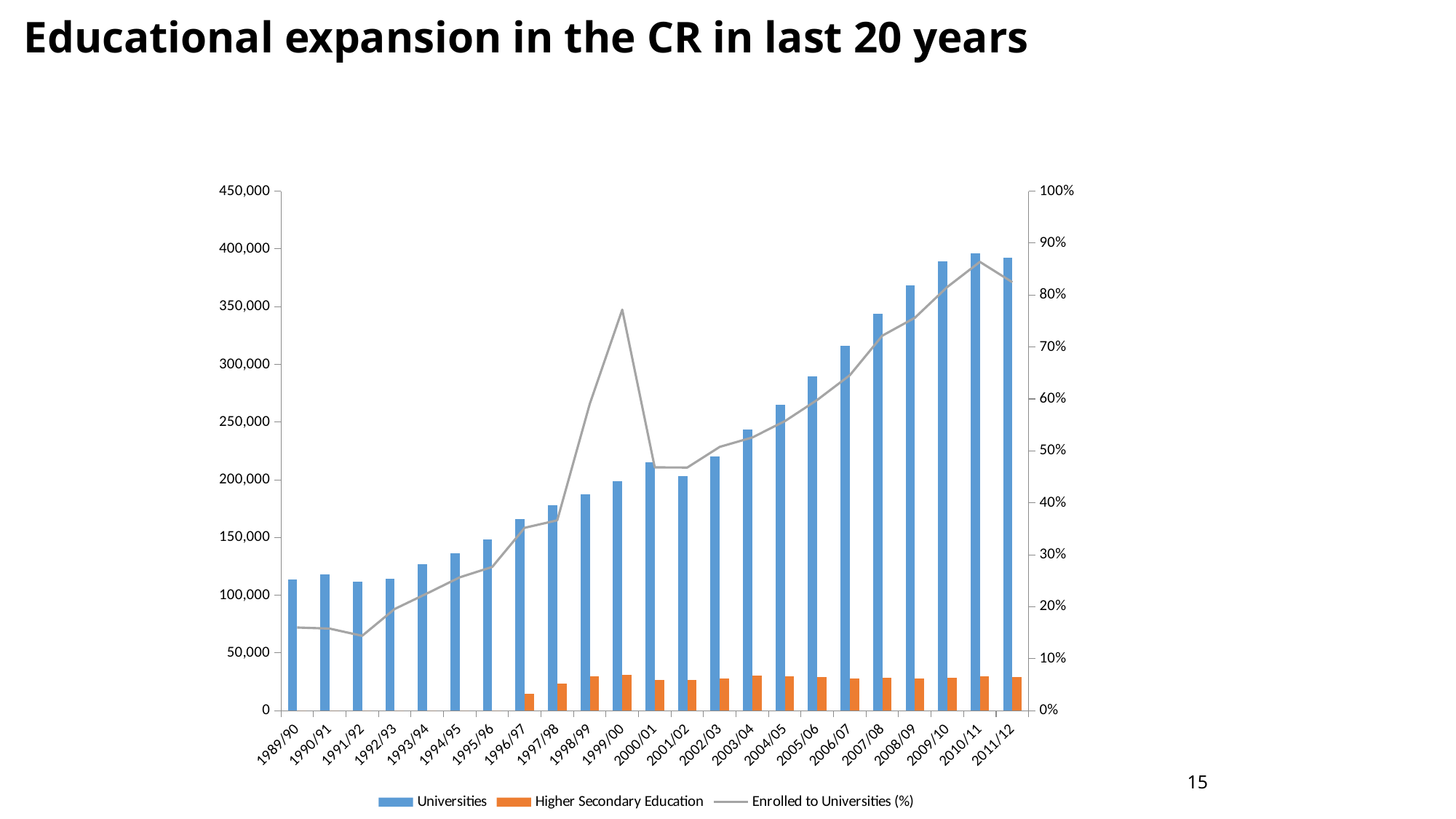
In which academic year does the Enrolled to Universities (%) line reach its highest point? 2010/11 Which series is plotted as a line rather than bars? Enrolled to Universities (%) What kind of chart is shown on the slide? A combined bar and line chart Is the Higher Secondary Education value for 1996/97 greater or less than 50,000? less Is the Enrolled to Universities (%) value for 1999/00 greater or less than 70%? greater Is the Enrolled to Universities (%) value for 2010/11 greater or less than 80%? greater How many series does the legend list? 3 Do the Universities bars generally rise or fall from 1989/90 to 2011/12? rise How many academic years are shown on the x axis? 23 Which year has the larger Universities value, 2000/01 or 2001/02? 2000/01